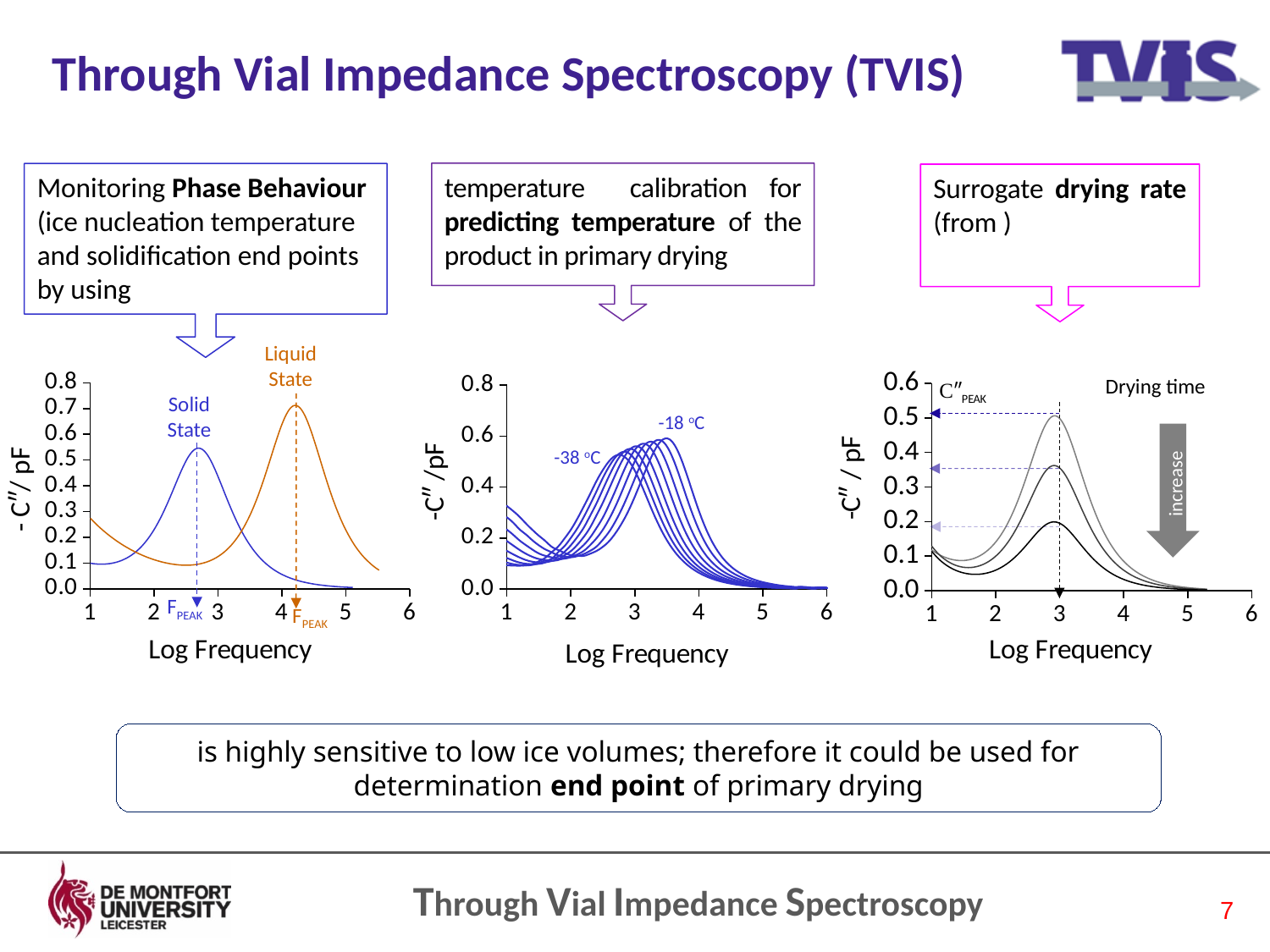
In the right chart, is the peak value of the highest curve greater or less than 0.4? greater In the right chart, at which Log Frequency value do the curves peak, as marked by the dashed vertical line? 3 In the middle chart, what are the two temperatures labelled on the curves? -38 °C and -18 °C In the right chart, how many curves are plotted? 3 What kind of chart is the left chart showing the Solid State and Liquid State curves? line chart What is the x-axis label of the left chart? Log Frequency In the left chart, is the peak value of the Solid State curve greater or less than 0.4? greater In the middle chart, is the peak value of the -18 °C curve greater or less than 0.4? greater In the left chart, which curve reaches the higher peak, Solid State or Liquid State? Liquid State In the left chart, how many curves are plotted? 2